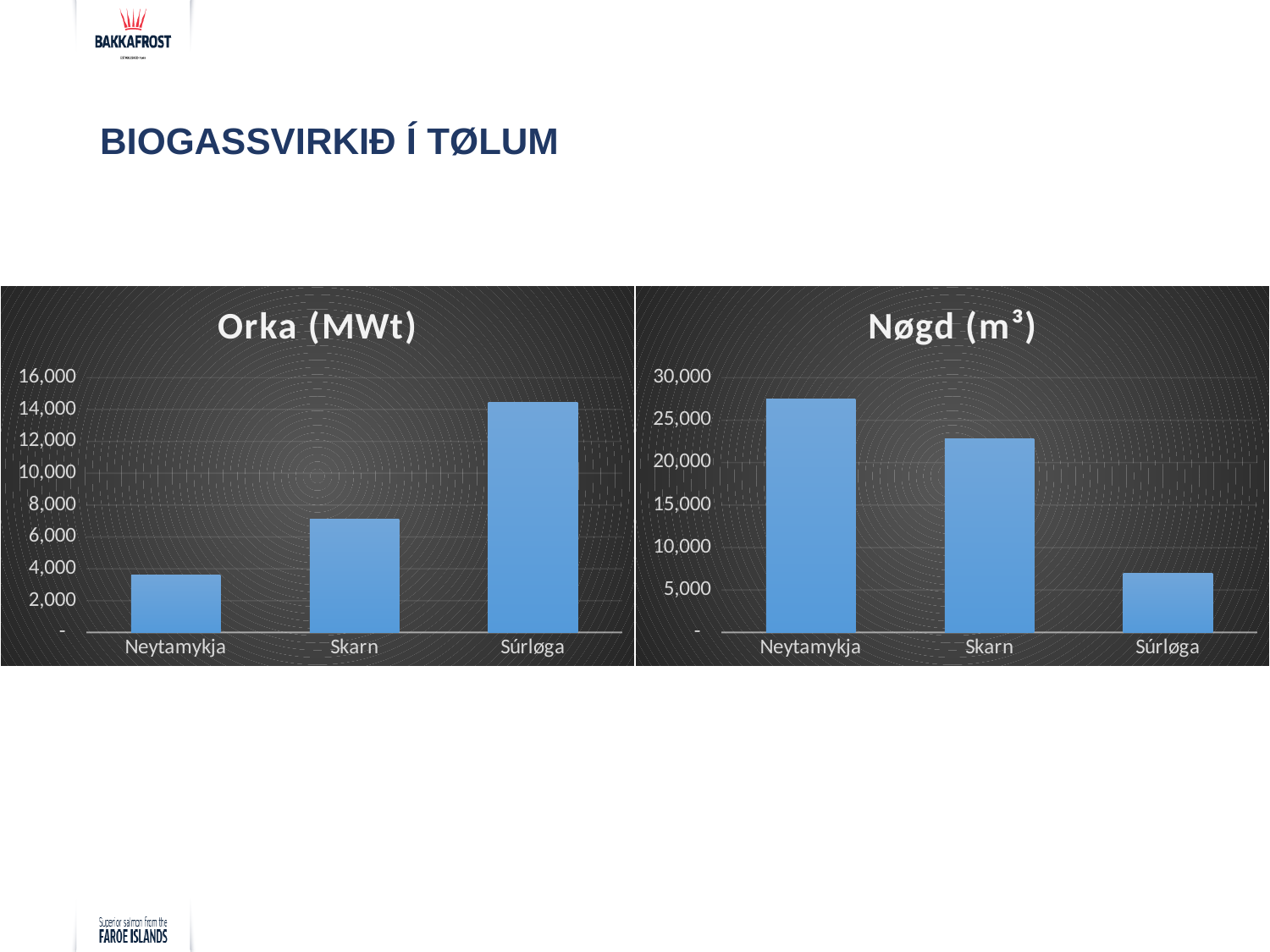
In the Nøgd (m³) chart, which category has the lowest value? Súrløga In the Orka (MWt) chart, which category has the highest value? Súrløga In the Nøgd (m³) chart, is the value for Súrløga greater or less than 10,000? less In the Nøgd (m³) chart, which category has the highest value? Neytamykja In the Nøgd (m³) chart, is the value for Neytamykja greater or less than 25,000? greater What kind of chart is the Nøgd (m³) chart? bar chart In the Orka (MWt) chart, do the values rise or fall from Neytamykja to Súrløga? rise In the Orka (MWt) chart, is the value for Skarn greater or less than 8,000? less In the Nøgd (m³) chart, which is larger, Skarn or Súrløga? Skarn How many categories are shown in the Orka (MWt) chart? 3 In the Orka (MWt) chart, which category has the lowest value? Neytamykja